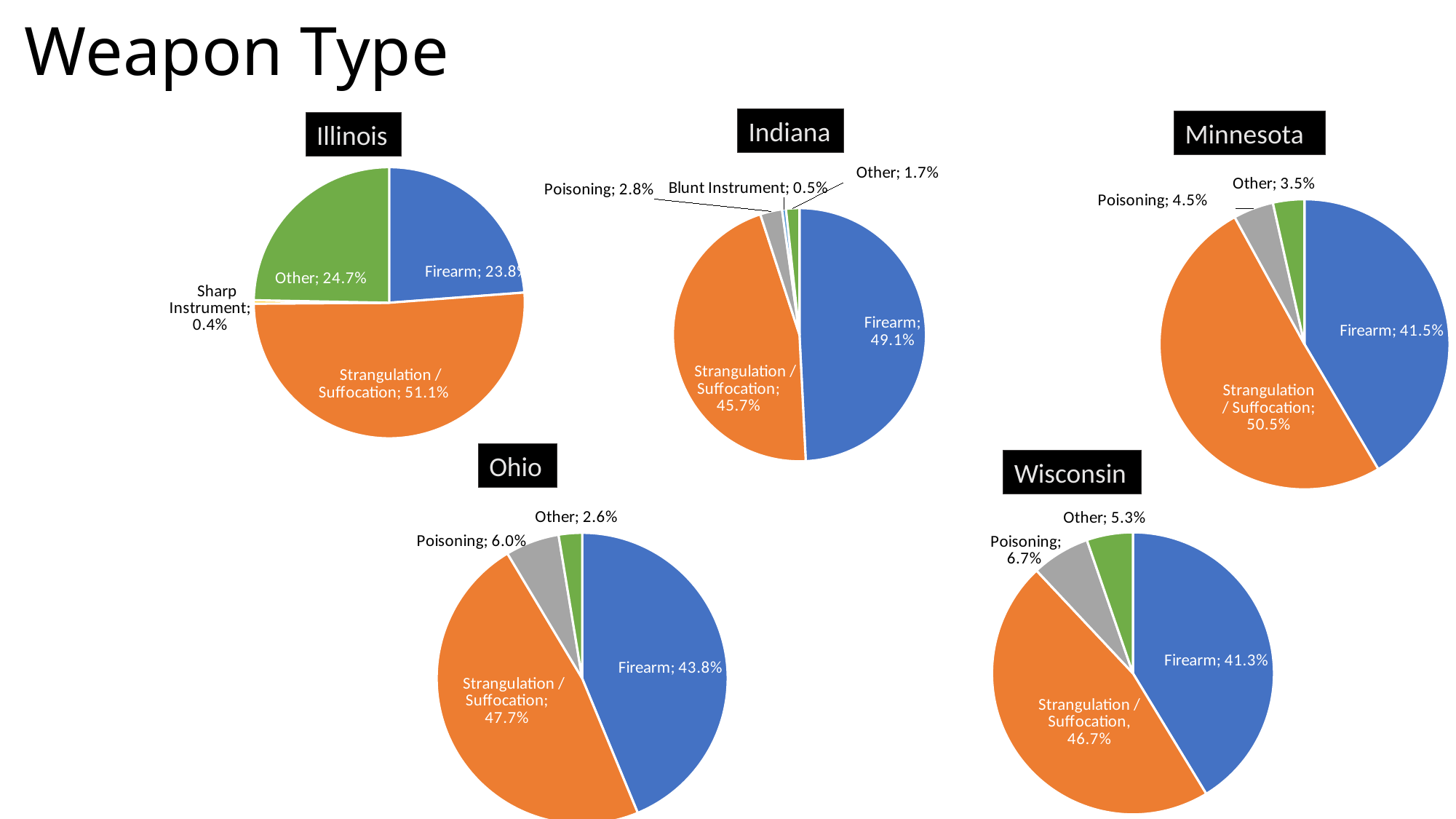
What kind of chart is used for Wisconsin? Pie chart In the Illinois chart, what share does Strangulation / Suffocation have? 51.1% In the Wisconsin chart, which category has the largest share? Strangulation / Suffocation In the Indiana chart, what is the value for Firearm? 49.1% In the Indiana chart, what is the difference between the Firearm and Strangulation / Suffocation shares? 3.4% How many pie charts are on the slide? 5 In the Ohio chart, which is larger, Firearm or Strangulation / Suffocation? Strangulation / Suffocation How many categories are shown in the Minnesota chart? 4 In the Illinois chart, which category has the smallest share? Sharp Instrument In the Ohio chart, what is the value for Other? 2.6% In the Minnesota chart, what is the value for Poisoning? 4.5% How many categories are shown in the Indiana chart? 5